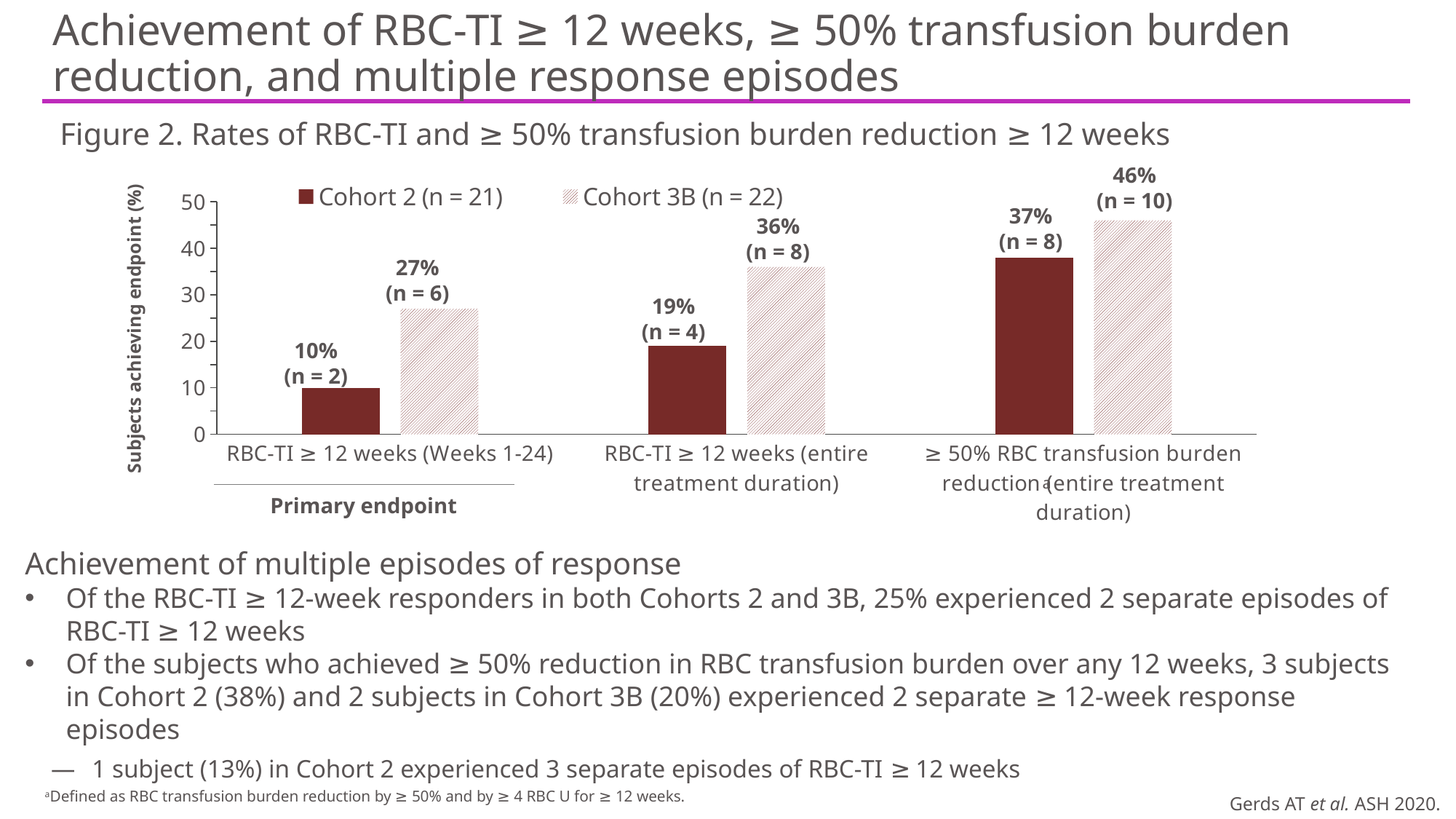
What percentage of Cohort 2 subjects achieved RBC-TI ≥ 12 weeks (Weeks 1-24)? 10% What percentage of Cohort 3B subjects achieved RBC-TI ≥ 12 weeks (entire treatment duration)? 36% Which endpoint is labelled as the primary endpoint? RBC-TI ≥ 12 weeks (Weeks 1-24) Which endpoint has the lowest value for Cohort 3B? RBC-TI ≥ 12 weeks (Weeks 1-24) Is the Cohort 2 value for ≥ 50% RBC transfusion burden reduction greater or less than 30? greater How many series does the legend list? 2 How many endpoint categories are shown on the x axis? 3 For RBC-TI ≥ 12 weeks (entire treatment duration), which cohort has the higher percentage? Cohort 3B What is the difference in percentage points between Cohort 3B and Cohort 2 for RBC-TI ≥ 12 weeks (Weeks 1-24)? 17 What kind of chart is shown in Figure 2? Bar chart How many Cohort 3B subjects achieved ≥ 50% RBC transfusion burden reduction (entire treatment duration)? n = 10 Which endpoint has the highest value for Cohort 2? ≥ 50% RBC transfusion burden reduction (entire treatment duration)